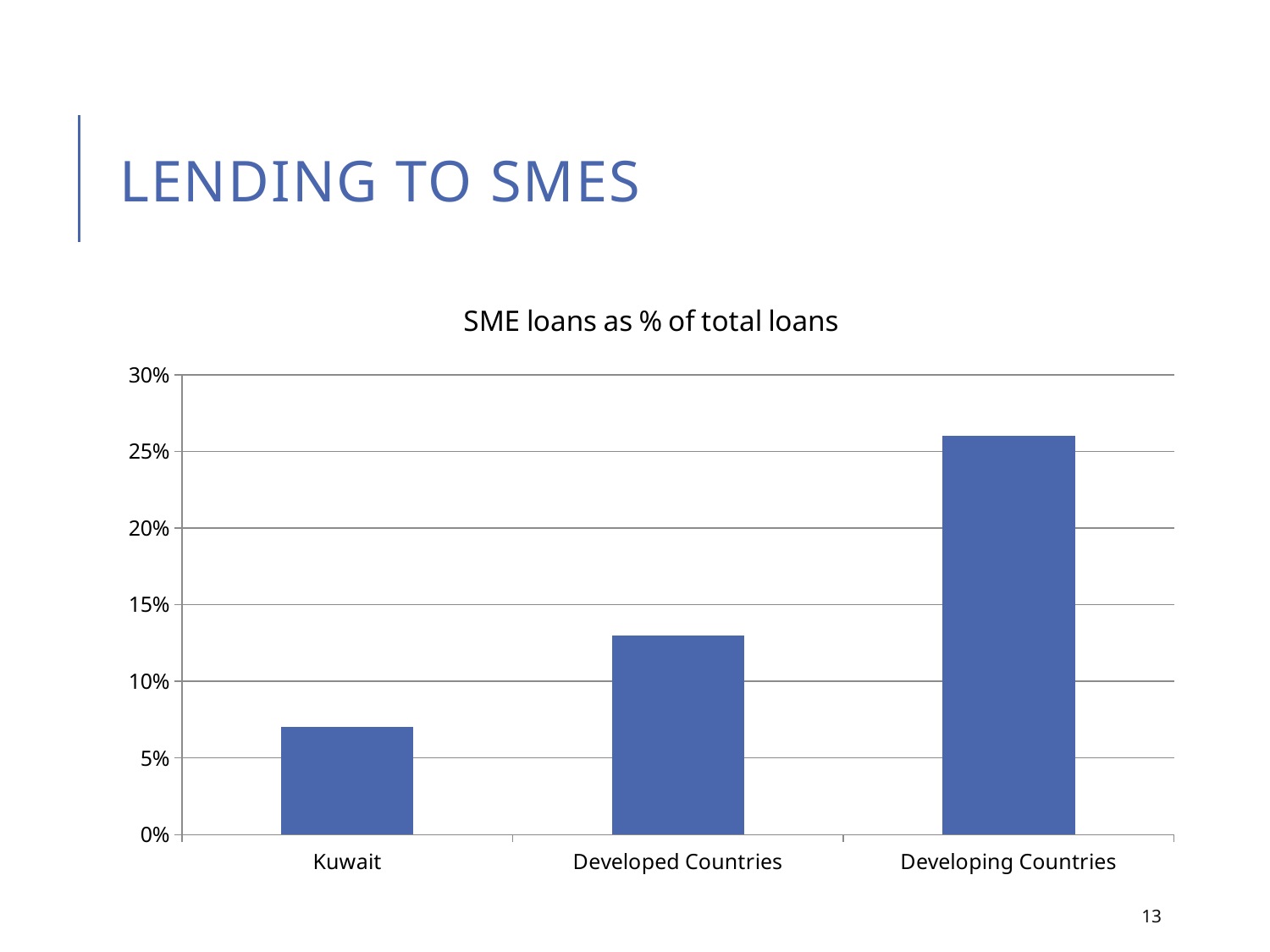
How many categories are shown on the x axis? 3 Is the value for Developed Countries greater or less than 10%? greater Is the value for Developed Countries greater or less than 15%? less Do the values rise or fall moving from left to right along the x axis? rise Which is larger, the value for Kuwait or the value for Developed Countries? Developed Countries Is the value for Developing Countries greater or less than 25%? greater What type of chart is shown on the slide? bar chart What is the title of the chart? SME loans as % of total loans What is the highest value shown on the y axis? 30% Which category has the highest value? Developing Countries Which category has the lowest value? Kuwait